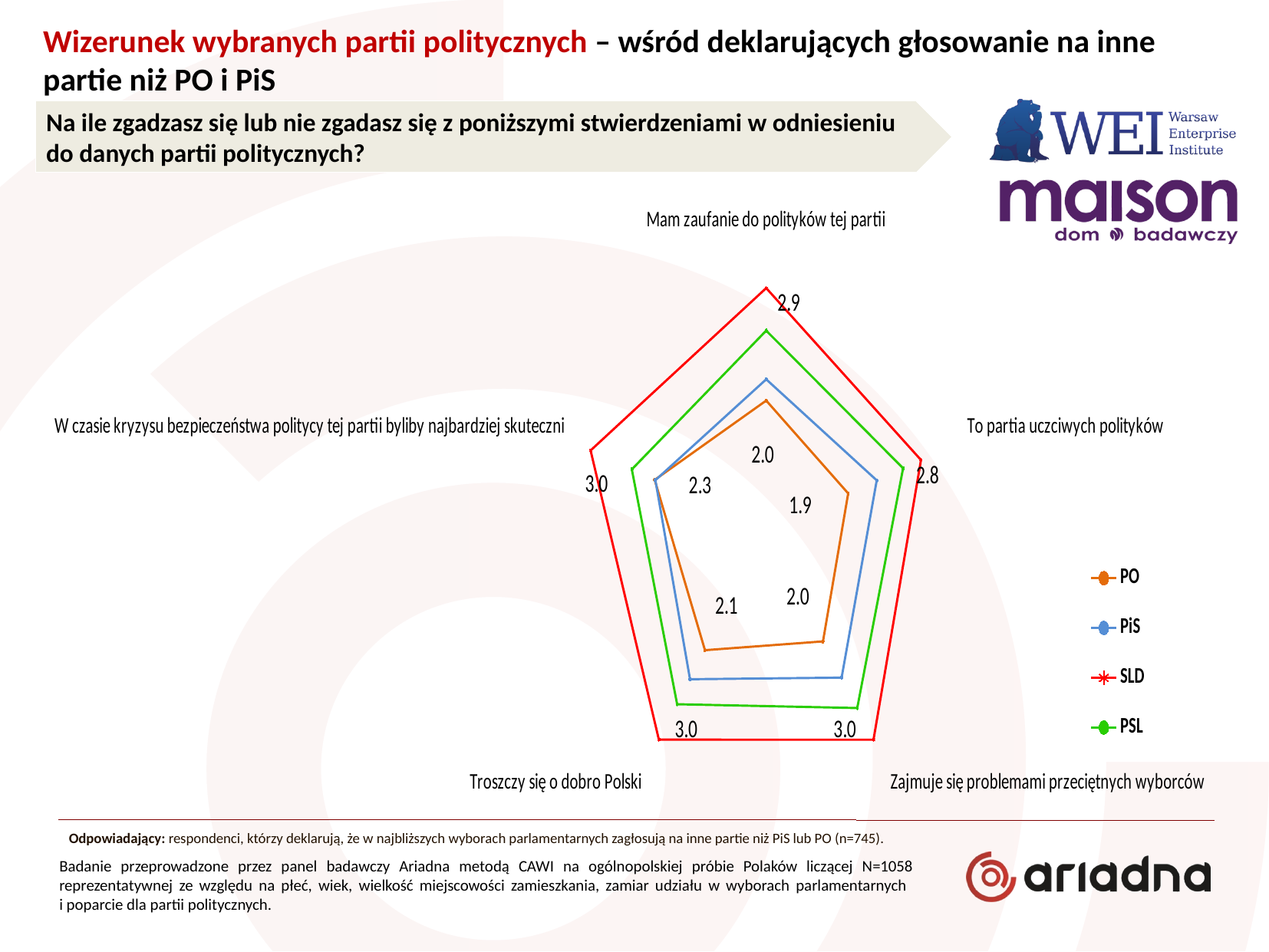
What is the difference between SLD and PO on "Troszczy się o dobro Polski"? 0.9 Which party has the highest value on "Zajmuje się problemami przeciętnych wyborców"? SLD What is the value for PO on "To partia uczciwych polityków"? 1.9 What kind of chart is shown on the slide? radar chart What is the value for SLD on "Troszczy się o dobro Polski"? 3.0 What is the value for PO on "W czasie kryzysu bezpieczeństwa politycy tej partii byliby najbardziej skuteczni"? 2.3 Which colour is used for the PSL series in the legend? green What is the value for SLD on "To partia uczciwych polityków"? 2.8 What is the value for SLD on "Mam zaufanie do polityków tej partii"? 2.9 Which party has the lowest value on "Mam zaufanie do polityków tej partii"? PO How many statements (axes) are plotted on the radar chart? 5 How many series does the legend list? 4